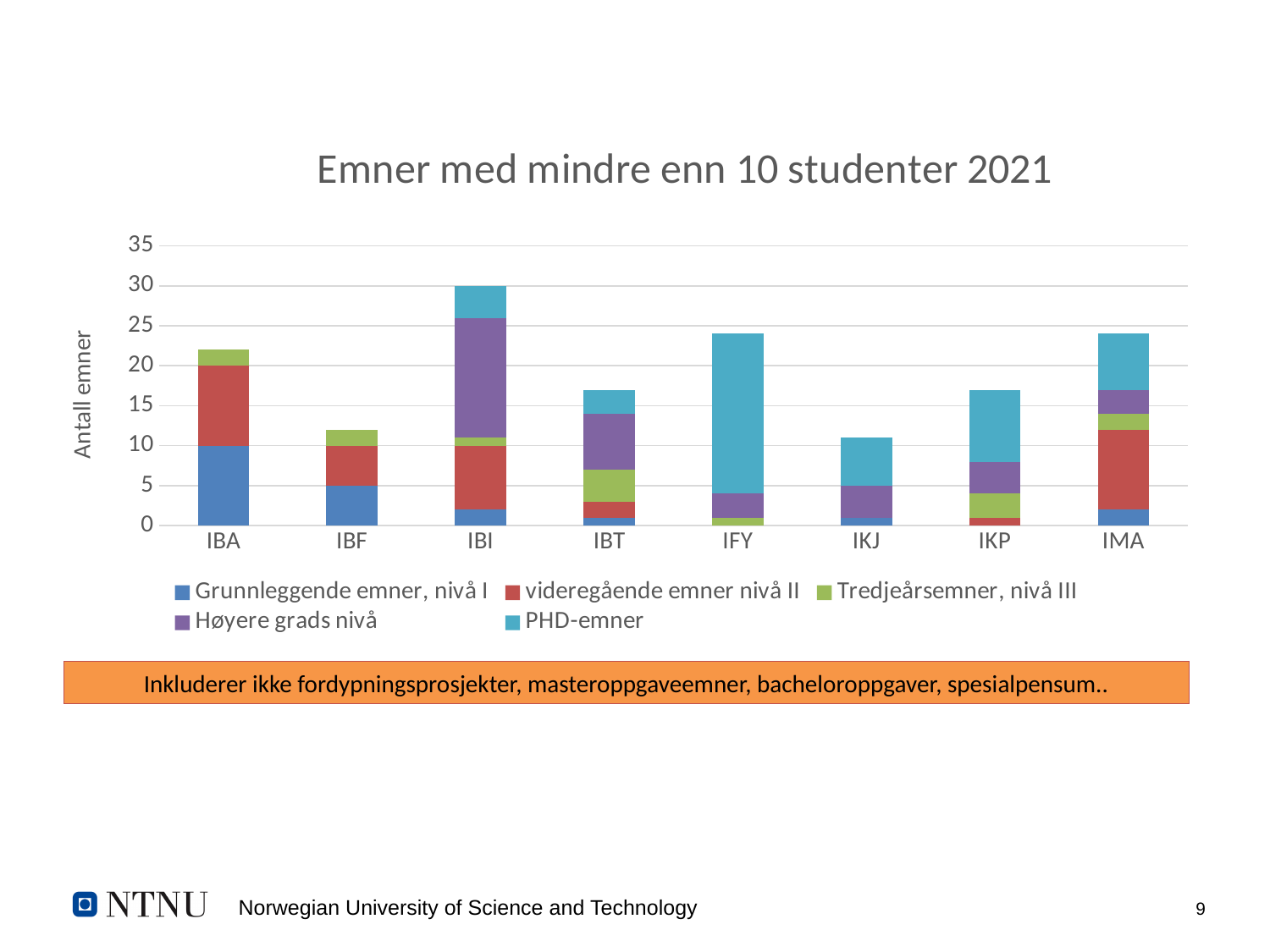
Which category has the tallest stacked bar? IBI What is the total height of the stacked bar for IBI? 30 Is the total value for IKJ greater or less than 15? less Is the total value for IBF greater or less than 15? less What kind of chart is shown on the slide? Stacked bar chart Which has a taller stacked bar, IFY or IKJ? IFY Is the total value for IFY greater or less than 20? greater How many categories (departments) are shown on the x axis? 8 How many series does the legend list? 5 Which has a taller stacked bar, IBI or IBA? IBI What is the value of the 'Grunnleggende emner, nivå I' segment for IBA? 10 What is the title of the chart? Emner med mindre enn 10 studenter 2021